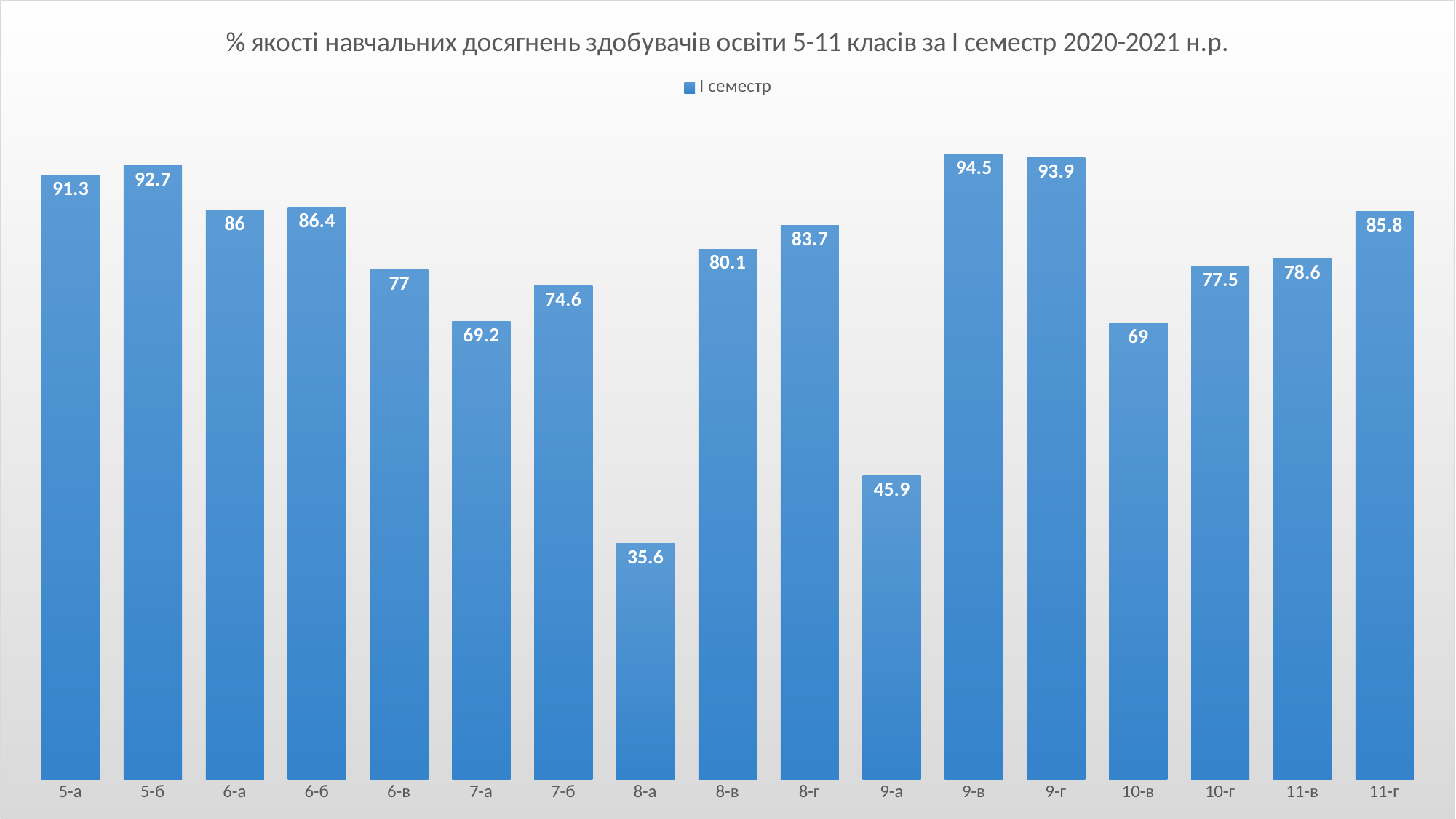
Which is larger, the value for 7-а or the value for 7-б? 7-б What is the value for 5-б? 92.7 What is the value for 10-г? 77.5 What is the value for 8-а? 35.6 How many series does the legend list? 1 What is the difference between the values for 6-б and 6-а? 0.4 What is the difference between the values for 9-в and 9-а? 48.6 Which class has the highest value? 9-в How many classes are shown on the chart? 17 Which class has the lowest value? 8-а What kind of chart is shown on the slide? bar chart What is the value for 11-г? 85.8